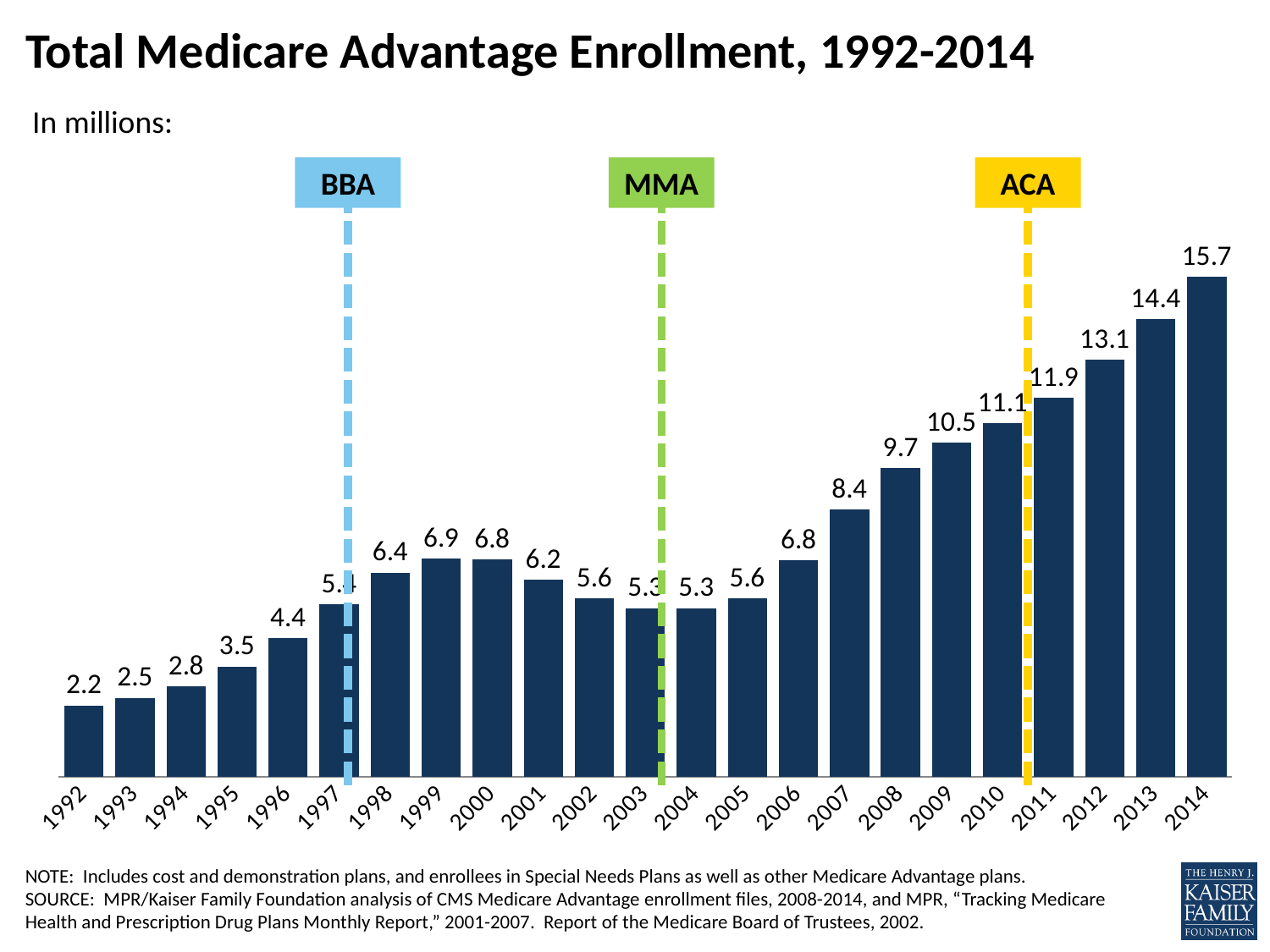
Which three policy labels are marked with dashed vertical lines on the chart? BBA, MMA, ACA What value is shown for 2007? 8.4 What was total Medicare Advantage enrollment in 2014? 15.7 What is the difference in enrollment between 2014 and 2013? 1.3 How many years are shown on the x axis? 23 Which year had higher enrollment, 2001 or 2005? 2001 What value is shown for 1999? 6.9 Which year has the highest enrollment? 2014 What kind of chart is this? Bar chart What is the difference in enrollment between 2007 and 2006? 1.6 What was total Medicare Advantage enrollment in 1992? 2.2 Which year has the lowest enrollment? 1992